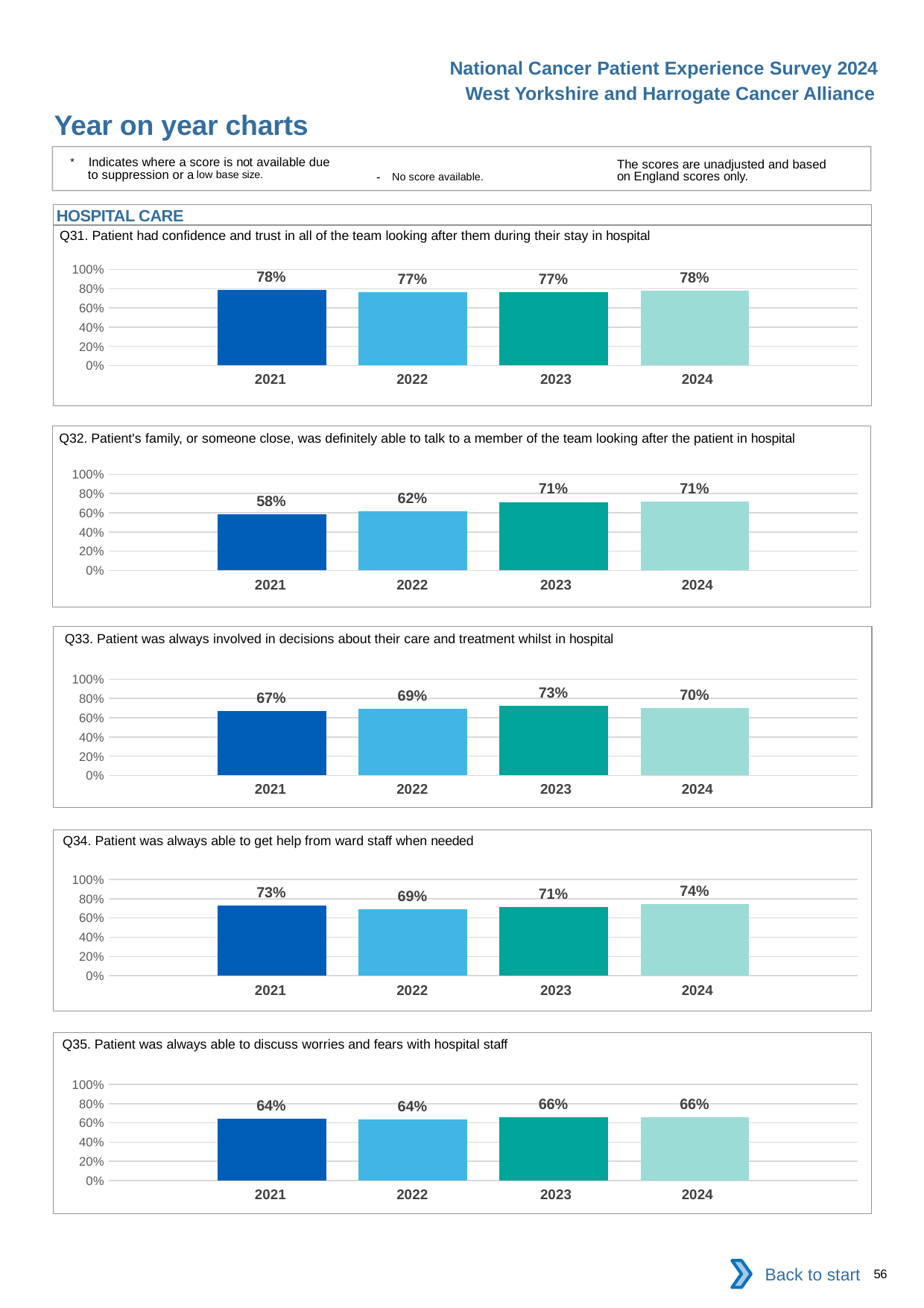
In the Q32 chart, what is the difference between the 2023 value and the 2021 value? 13% In the Q32 chart, what is the value for 2022? 62% In the Q32 chart, which year has the lowest value? 2021 What type of chart is the Q31 chart? Bar chart In the Q34 chart, which is larger, the value for 2022 or the value for 2024? 2024 How many years are shown in the Q35 chart? 4 In the Q34 chart, what is the difference between the 2024 value and the 2022 value? 5% In the Q33 chart, what is the value for 2024? 70% In the Q32 chart, do the values generally rise or fall from 2021 to 2024? Rise In the Q33 chart, which year has the highest value? 2023 In the Q31 chart, what is the value for 2021? 78% In the Q35 chart, what is the value for 2023? 66%